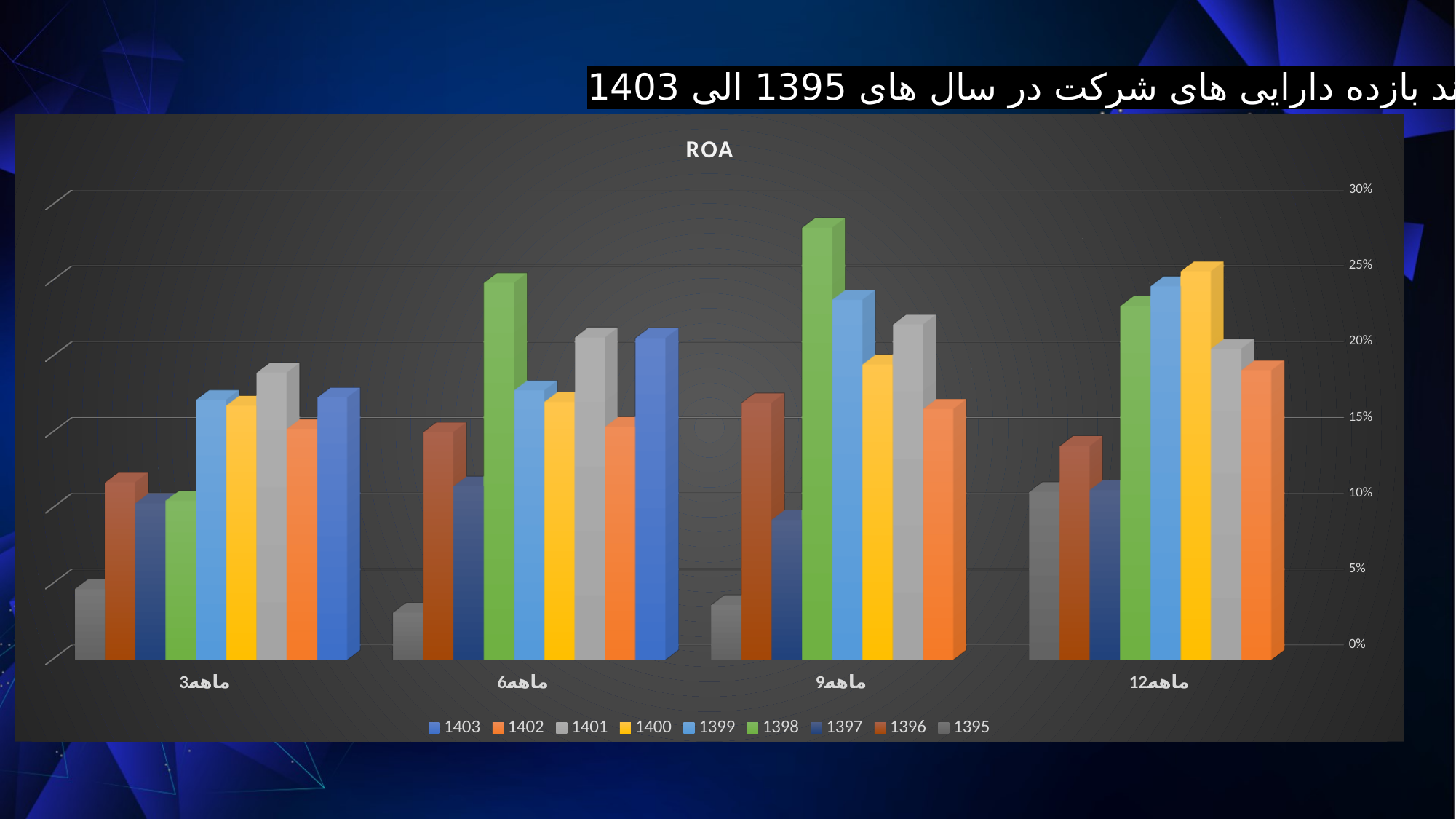
What kind of chart is shown on the slide? bar chart Do the values for the 1399 series rise or fall from 3ماهه to 12ماهه? rise What is the title of the chart? ROA How many categories are shown on the x axis? 4 How many series does the legend list? 9 Which series has the lowest value in the 6ماهه category? 1395 Is the value for 1398 in the 9ماهه category greater or less than 25%? greater Which series has the highest value in the 9ماهه category? 1398 Is the value for 1400 in the 12ماهه category greater or less than 20%? greater In the 6ماهه category, which is larger, the value for 1398 or the value for 1399? 1398 In the 3ماهه category, which is larger, the value for 1401 or the value for 1402? 1401